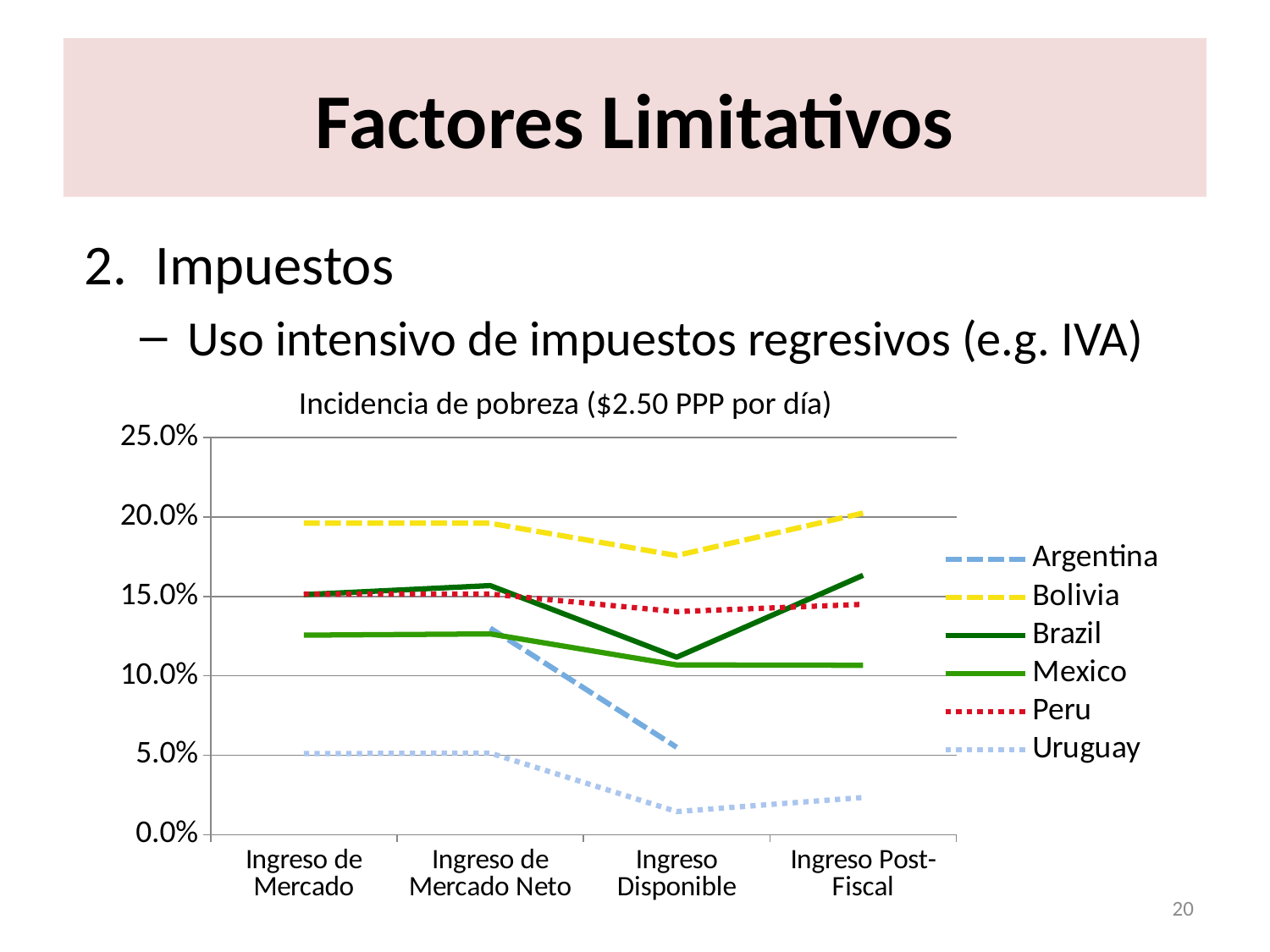
Is the value for Argentina at Ingreso Disponible greater or less than 10.0%? less Is the value for Brazil at Ingreso Post-Fiscal greater or less than 15.0%? greater Which country has the highest poverty incidence at Ingreso Post-Fiscal? Bolivia What kind of chart is shown on the slide? line chart Which country has the lowest poverty incidence at Ingreso Disponible? Uruguay Is the value for Bolivia at Ingreso Disponible greater or less than 20.0%? less How many series does the legend list? 6 Does the Uruguay line rise or fall from Ingreso de Mercado Neto to Ingreso Disponible? fall How many categories are shown on the x axis? 4 What is the title of the chart? Incidencia de pobreza ($2.50 PPP por día) At Ingreso Post-Fiscal, which is larger, the value for Brazil or the value for Mexico? Brazil